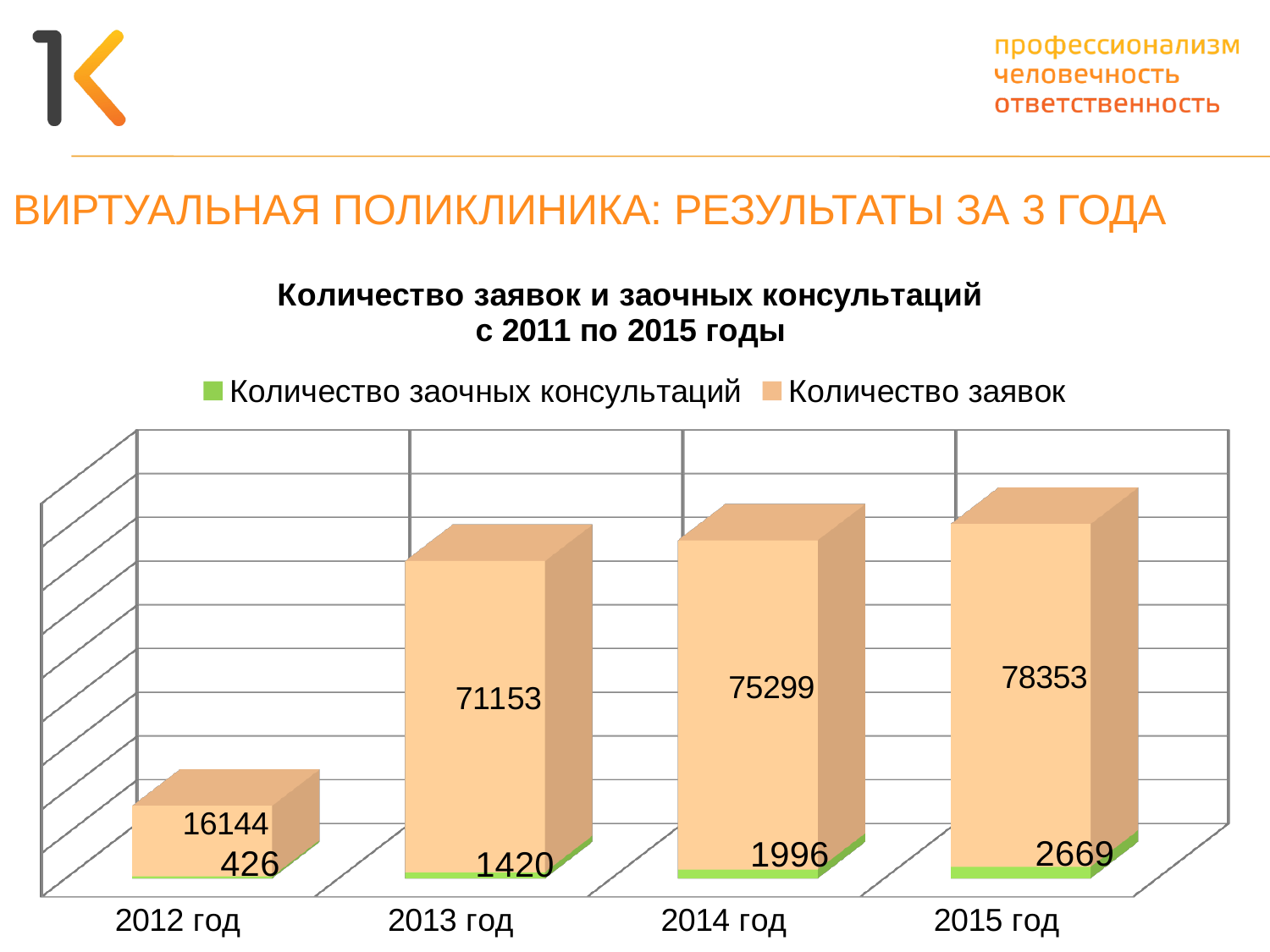
What is the value of Количество заявок for 2013 год? 71153 What is the value of Количество заявок for 2012 год? 16144 Which is larger: Количество заявок in 2013 год or in 2014 год? 2014 год What is the value of Количество заочных консультаций for 2015 год? 2669 How many years are shown on the x axis? 4 What kind of chart is shown on the slide? Stacked bar chart What is the difference between Количество заочных консультаций in 2014 год and 2013 год? 576 Which year has the lowest value for Количество заочных консультаций? 2012 год What is the total of the stacked bar for 2014 год? 77295 Which year has the highest value for Количество заявок? 2015 год What is the difference between Количество заявок in 2015 год and 2014 год? 3054 How many series does the legend list? 2